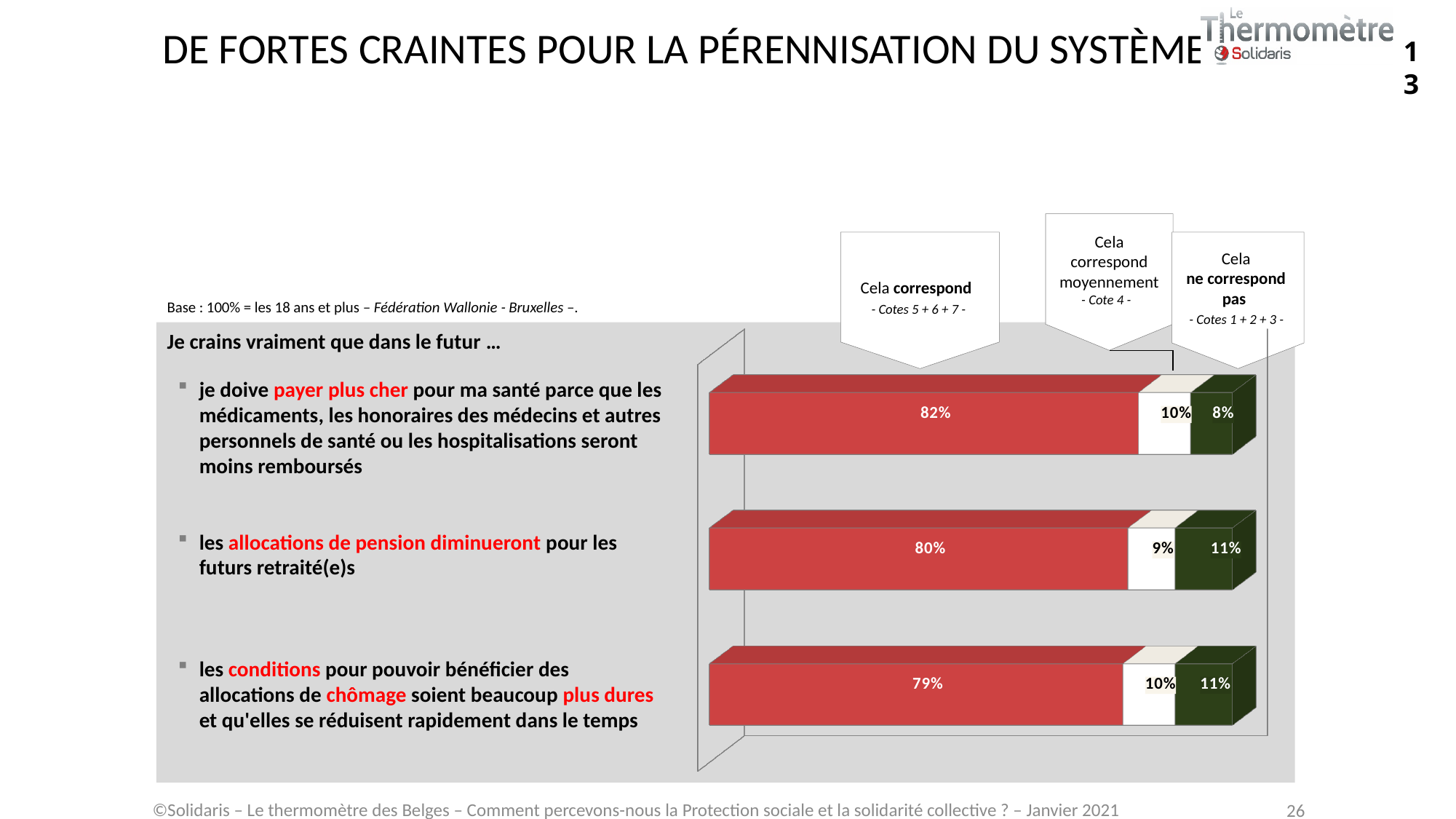
How many response categories (series) does the chart show for each bar? 3 Is the 'Cela ne correspond pas' value larger for the health-cost statement or for the pension statement? the pension statement (11% vs 8%) What percentage of respondents say 'Cela correspond' for the statement that they fear they will have to pay more for their health (payer plus cher pour ma santé)? 82% What type of chart is shown on the slide? stacked horizontal bar chart Which statement has the highest 'Cela correspond' percentage? je doive payer plus cher pour ma santé (82%) What is the difference between the 'Cela correspond' values for the health-cost statement (82%) and the unemployment-conditions statement (79%)? 3 percentage points Which statement has the lowest 'Cela correspond' percentage? les conditions pour bénéficier des allocations de chômage soient beaucoup plus dures (79%) What is the 'Cela ne correspond pas' value for the statement about pension allowances decreasing (les allocations de pension diminueront)? 11% How many statements (bars) are shown in the chart? 3 What is the 'Cela correspond moyennement' value for the statement about unemployment benefit conditions becoming much harder (conditions ... chômage ... plus dures)? 10% Which response category is shown in red in the chart? Cela correspond (Cotes 5 + 6 + 7) What is the total of the three segments for the pension statement bar (80% + 9% + 11%)? 100%